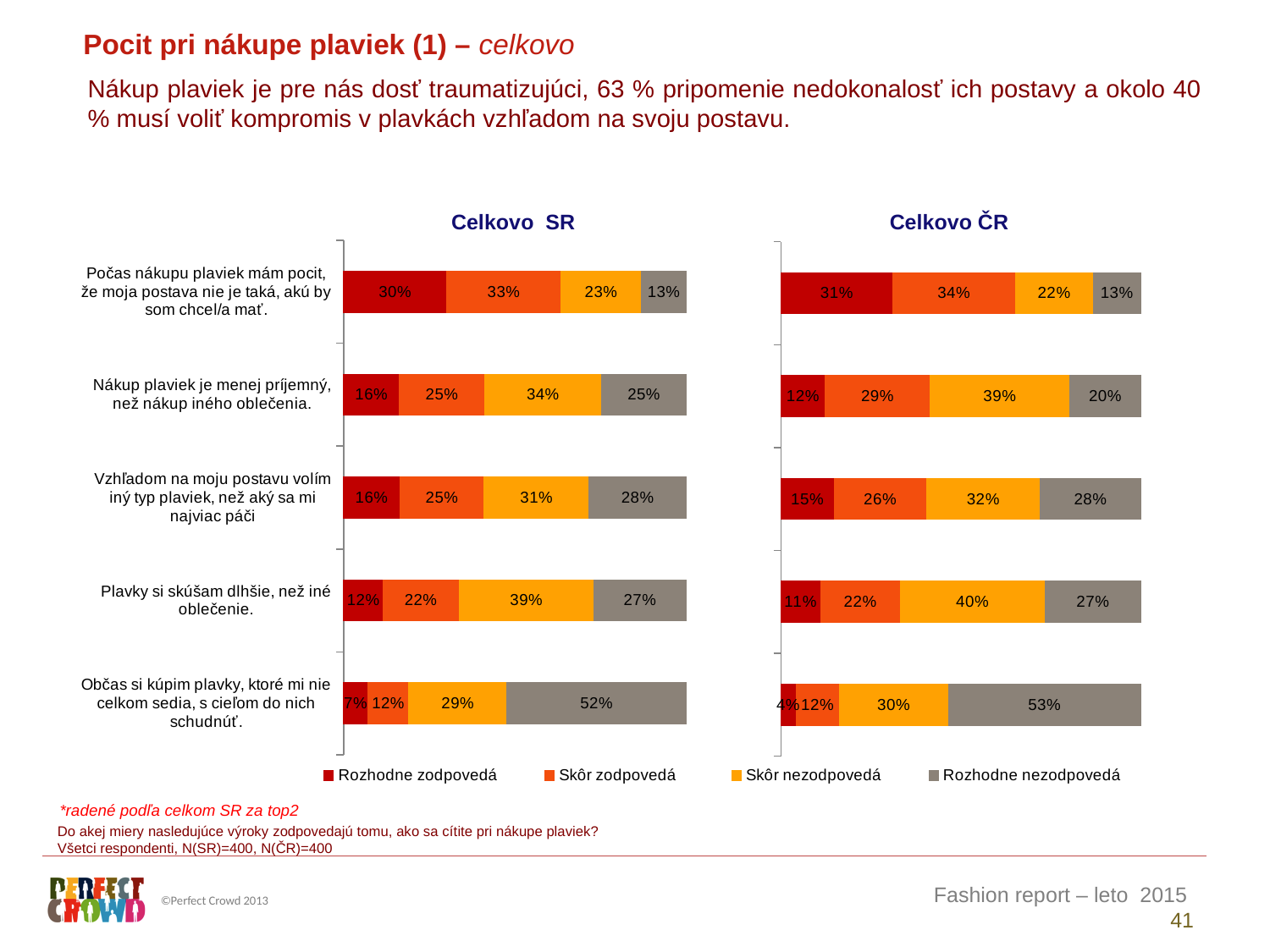
Which chart shows a larger 'Rozhodne nezodpovedá' value for 'Nákup plaviek je menej príjemný, než nákup iného oblečenia.', 'Celkovo SR' or 'Celkovo ČR'? Celkovo SR In the 'Celkovo SR' chart, what is the 'Skôr nezodpovedá' value for 'Plavky si skúšam dlhšie, než iné oblečenie.'? 39% How many statements (categories) are shown in the 'Celkovo SR' chart? 5 In the 'Celkovo SR' chart, which statement has the lowest 'Rozhodne zodpovedá' value? Občas si kúpim plavky, ktoré mi nie celkom sedia, s cieľom do nich schudnúť. In the 'Celkovo SR' chart, what is the combined total of 'Rozhodne zodpovedá' and 'Skôr zodpovedá' for 'Vzhľadom na moju postavu volím iný typ plaviek, než aký sa mi najviac páči'? 41% In the 'Celkovo SR' chart, what is the 'Rozhodne zodpovedá' value for 'Počas nákupu plaviek mám pocit, že moja postava nie je taká, akú by som chcel/a mať.'? 30% In the 'Celkovo ČR' chart, which statement has the highest 'Skôr nezodpovedá' value? Plavky si skúšam dlhšie, než iné oblečenie. Which legend entry is shown in grey? Rozhodne nezodpovedá In the 'Celkovo ČR' chart, what is the difference between the 'Skôr zodpovedá' values for 'Nákup plaviek je menej príjemný, než nákup iného oblečenia.' and 'Plavky si skúšam dlhšie, než iné oblečenie.'? 7% How many series does the legend list for the charts? 4 What type of chart is 'Celkovo ČR'? Stacked bar chart In the 'Celkovo ČR' chart, what is the 'Rozhodne nezodpovedá' value for 'Občas si kúpim plavky, ktoré mi nie celkom sedia, s cieľom do nich schudnúť.'? 53%